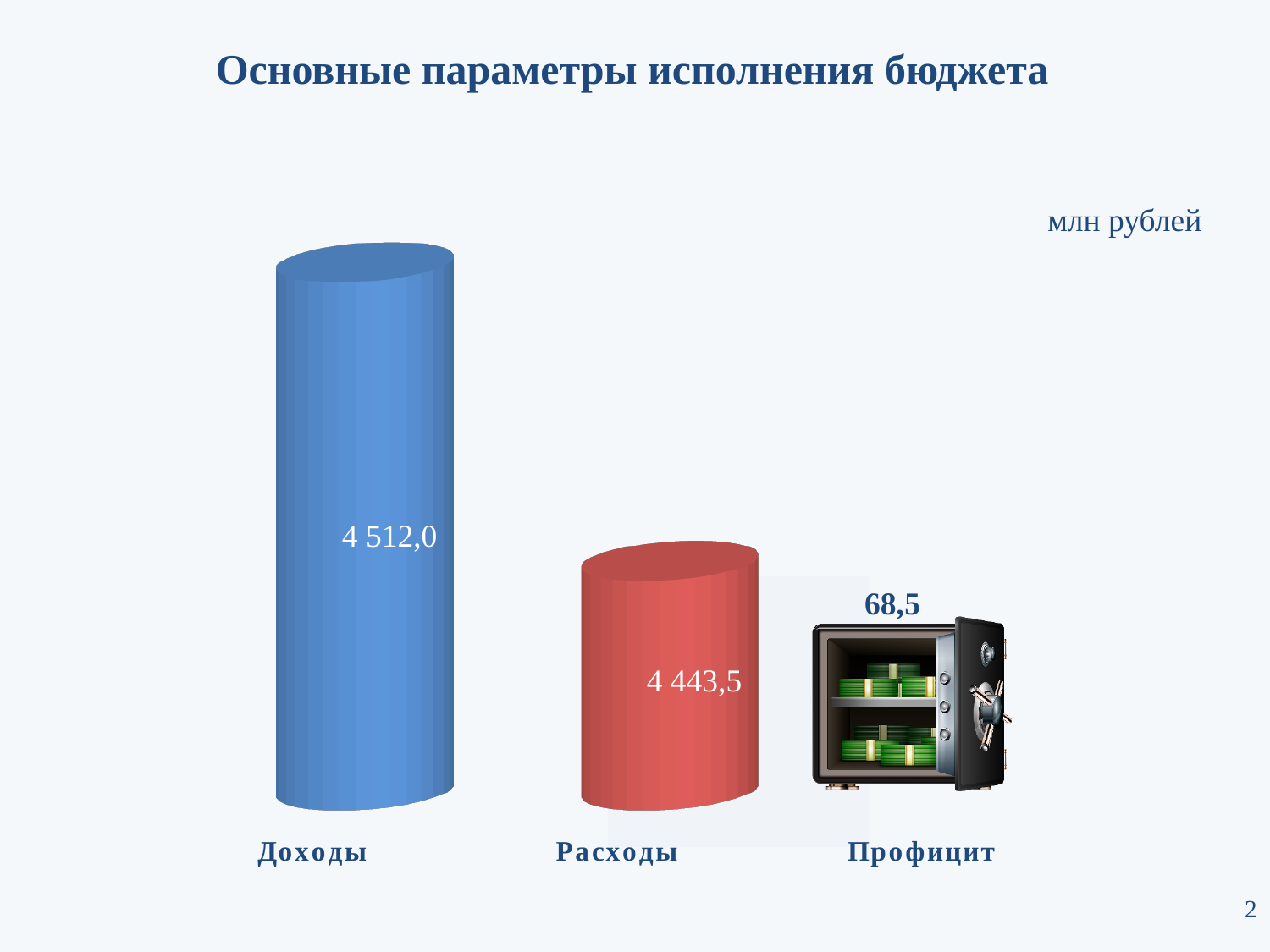
What is the value shown for Доходы? 4 512,0 What is the difference between the values for Доходы and Расходы? 68,5 Which category has the lowest value? Профицит What is the title of the slide's chart? Основные параметры исполнения бюджета Which category has the highest value? Доходы Which is larger, the value for Доходы or the value for Расходы? Доходы Do the values rise or fall from left to right across the categories? Fall In what units are the chart values given? млн рублей How many categories are shown on the chart? 3 What is the value shown for Расходы? 4 443,5 What is the value shown for Профицит? 68,5 What kind of chart is shown on the slide? Bar chart